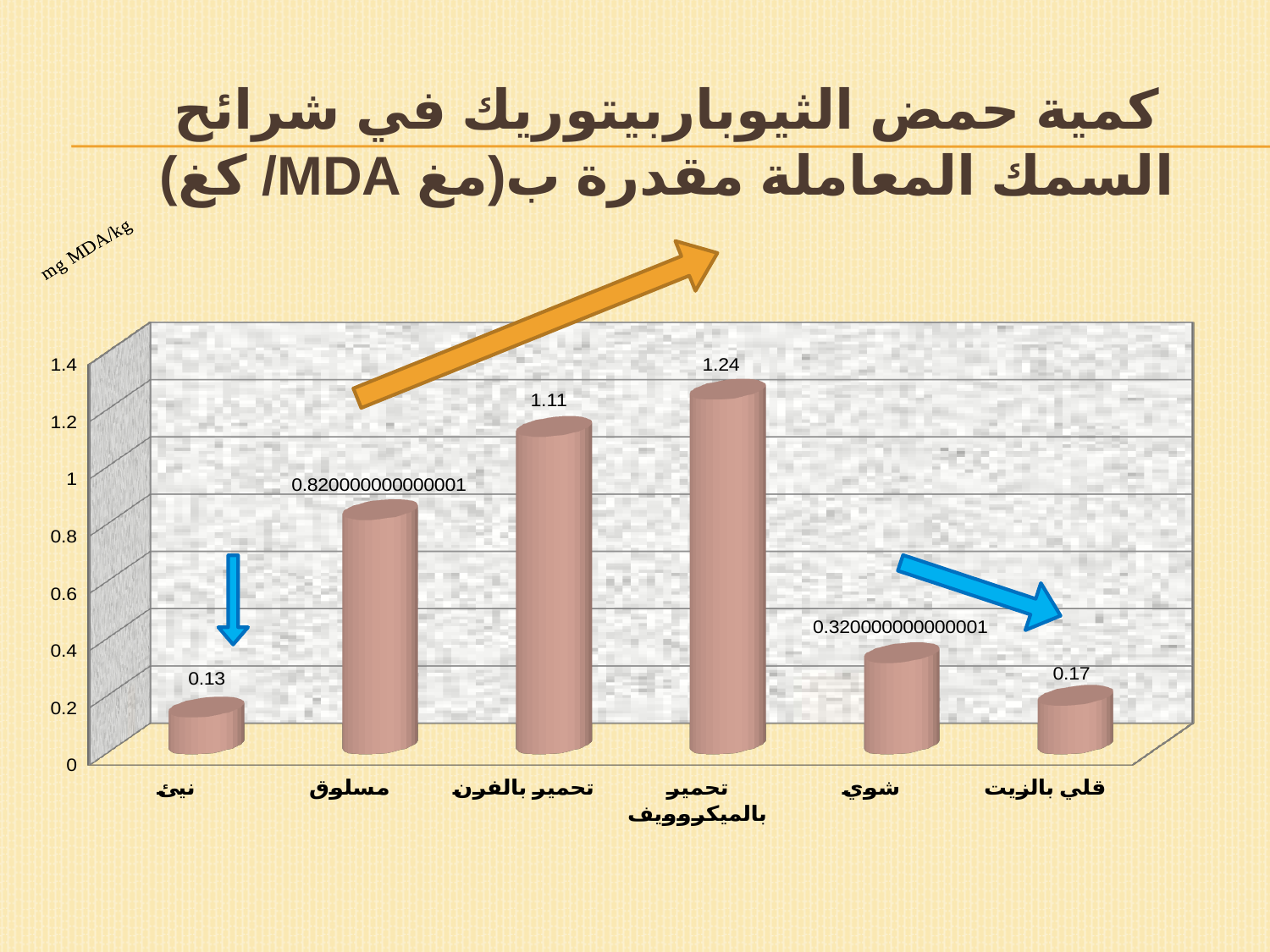
What is the value for تحمير بالميكروويف? 1.24 What is the difference between the values for قلي بالزيت and نيئ? 0.04 What is the value for تحمير بالفرن? 1.11 Is the value for مسلوق greater or less than 0.8? greater What is the value for نيئ? 0.13 How many categories are shown on the x axis? 6 Which category has the lowest value? نيئ Which category has the highest value? تحمير بالميكروويف Which is larger, the value for مسلوق or the value for شوي? مسلوق What kind of chart is shown on the slide? bar chart What is the value for قلي بالزيت? 0.17 What is the difference between the values for تحمير بالميكروويف and تحمير بالفرن? 0.13